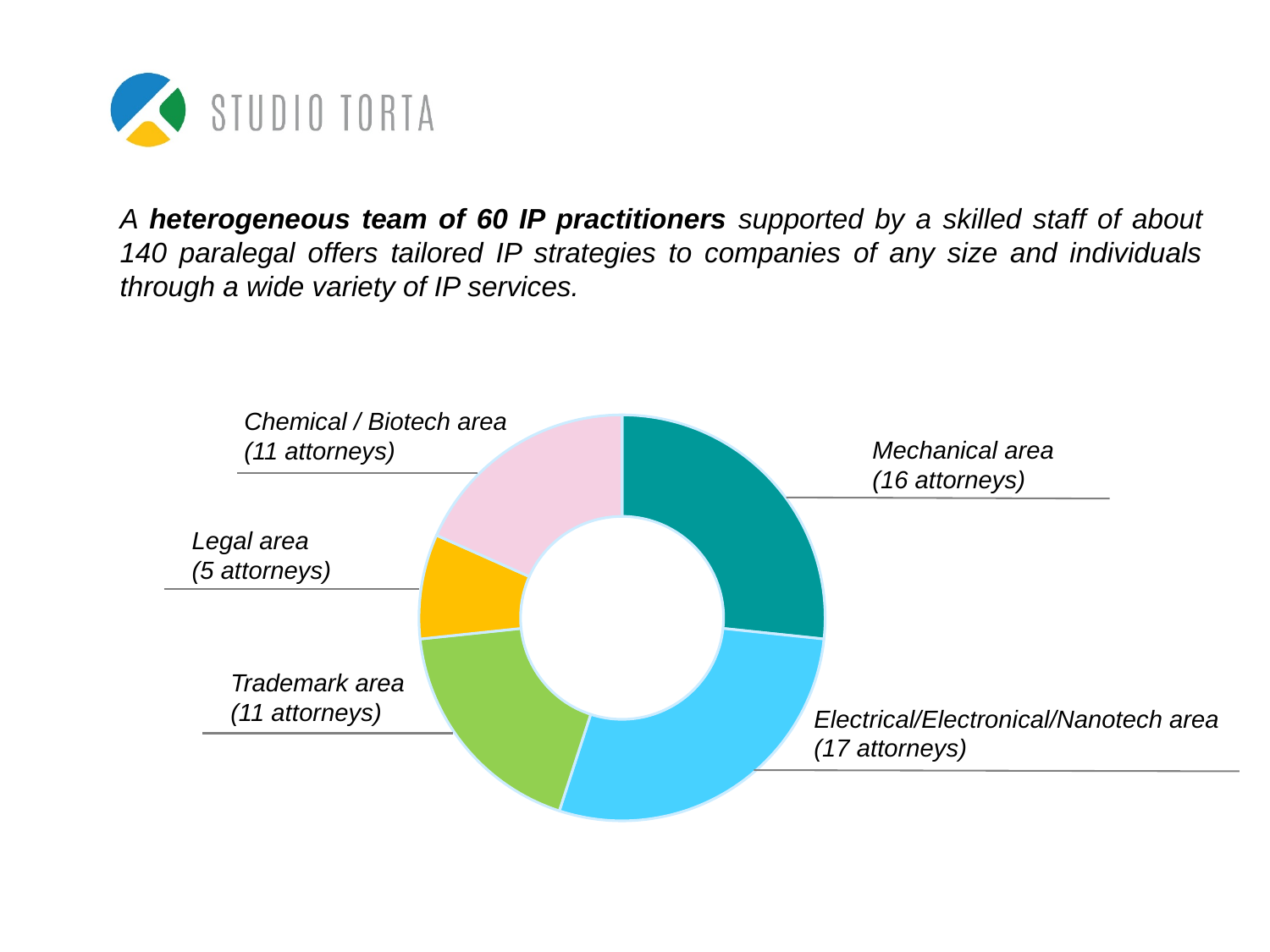
How many attorneys are in the Legal area? 5 attorneys How many areas are shown in the chart? 5 How many attorneys are in the Mechanical area? 16 attorneys How many more attorneys are in the Mechanical area than in the Legal area? 11 How many attorneys are in the Trademark area? 11 attorneys How many attorneys are in the Electrical/Electronical/Nanotech area? 17 attorneys What kind of chart is shown on the slide? Doughnut chart What is the total number of attorneys across all areas in the chart? 60 What is the difference in attorneys between the Electrical/Electronical/Nanotech area and the Trademark area? 6 Which has more attorneys, the Chemical / Biotech area or the Legal area? Chemical / Biotech area Which area has the most attorneys? Electrical/Electronical/Nanotech area Which area has the fewest attorneys? Legal area